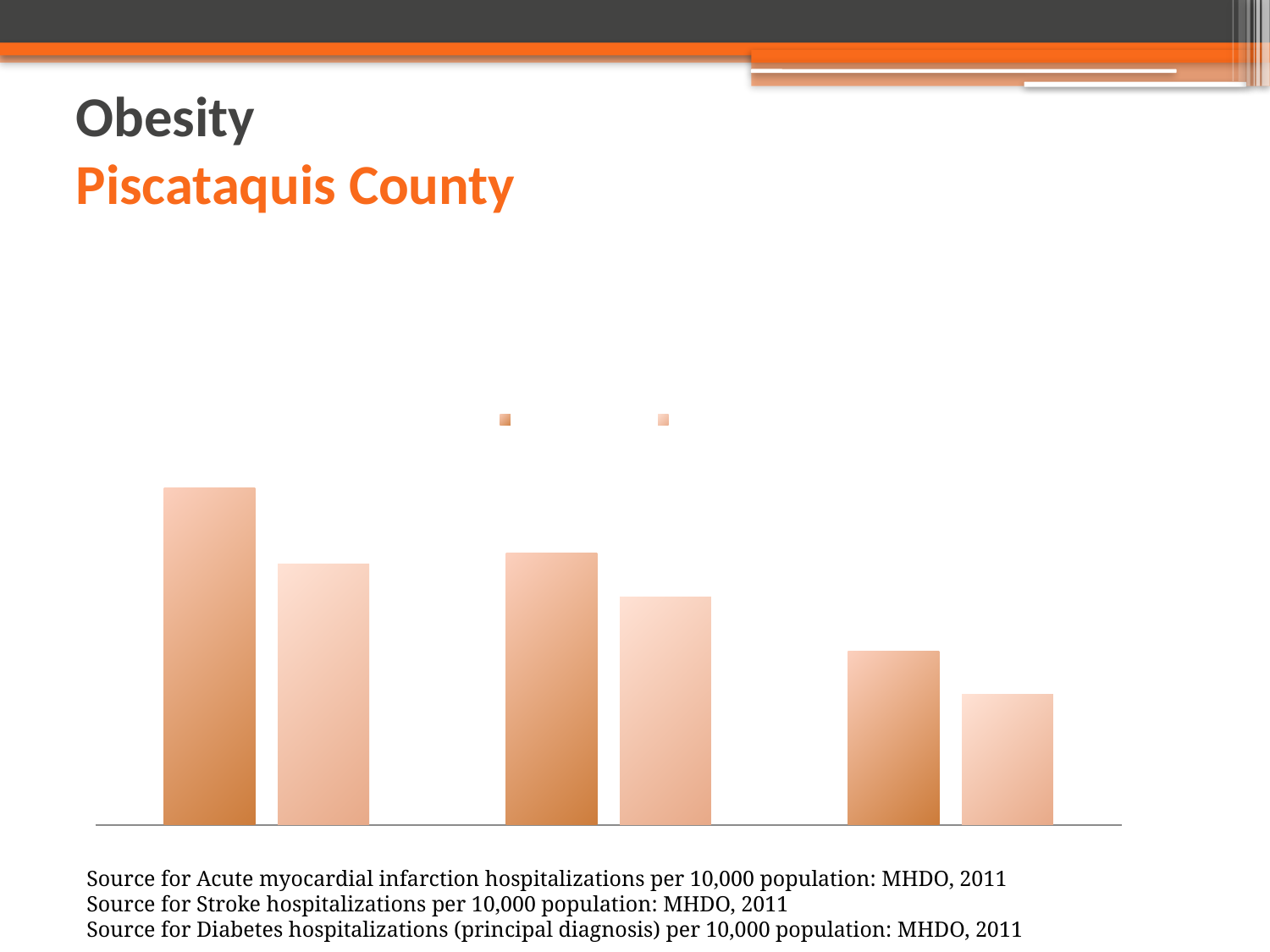
In the middle group, which bar is taller: the darker bar or the lighter bar? the darker bar In the leftmost group, which bar is taller: the darker bar or the lighter bar? the darker bar Do the bar heights rise or fall moving from the left group to the right group? fall What kind of chart is shown on the slide? bar chart What colour are the bars on the chart? orange Which bar is the tallest on the chart: the darker bar in the leftmost group or the darker bar in the rightmost group? the darker bar in the leftmost group Which group of bars has the lowest values: the leftmost, middle, or rightmost group? the rightmost group How many groups of bars are plotted on the chart? 3 How many series does the legend list? 2 How many bars are plotted in total on the chart? 6 Which group of bars has the highest values: the leftmost, middle, or rightmost group? the leftmost group